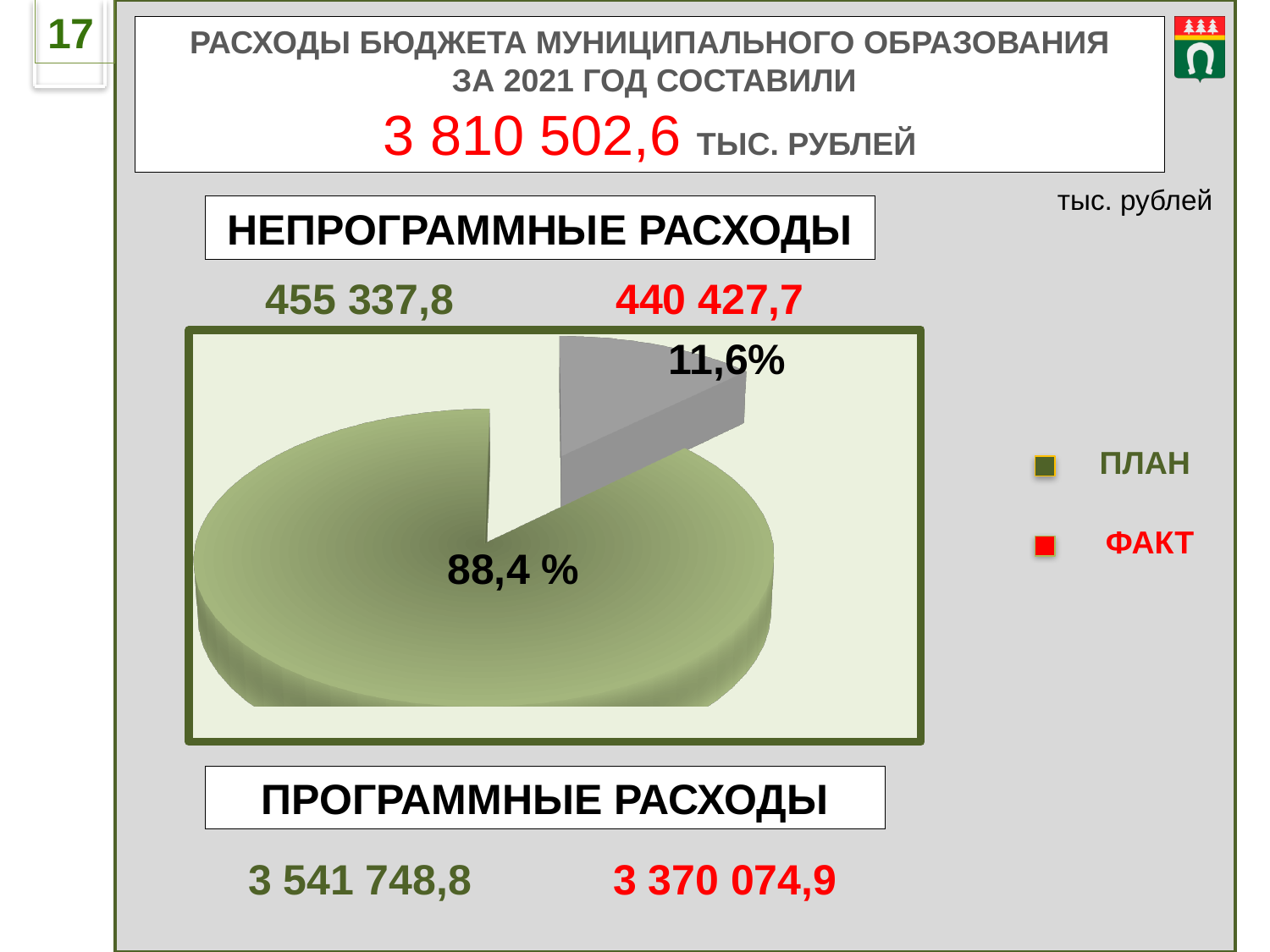
Which slice of the pie is larger, ПРОГРАММНЫЕ РАСХОДЫ or НЕПРОГРАММНЫЕ РАСХОДЫ? ПРОГРАММНЫЕ РАСХОДЫ What is the ПЛАН value for ПРОГРАММНЫЕ РАСХОДЫ? 3 541 748,8 What is the difference between the ПЛАН and ФАКТ values for НЕПРОГРАММНЫЕ РАСХОДЫ? 14 910,1 What is the ФАКТ value for ПРОГРАММНЫЕ РАСХОДЫ? 3 370 074,9 What kind of chart is shown on the slide? pie chart What is the ПЛАН value for НЕПРОГРАММНЫЕ РАСХОДЫ? 455 337,8 What share of the pie does the ПРОГРАММНЫЕ РАСХОДЫ slice represent? 88,4 % How many slices does the pie chart have? 2 What share of the pie does the НЕПРОГРАММНЫЕ РАСХОДЫ slice represent? 11,6% What is the ФАКТ value for НЕПРОГРАММНЫЕ РАСХОДЫ? 440 427,7 What two entries does the legend list? ПЛАН and ФАКТ What is the difference between the ПЛАН and ФАКТ values for ПРОГРАММНЫЕ РАСХОДЫ? 171 673,9